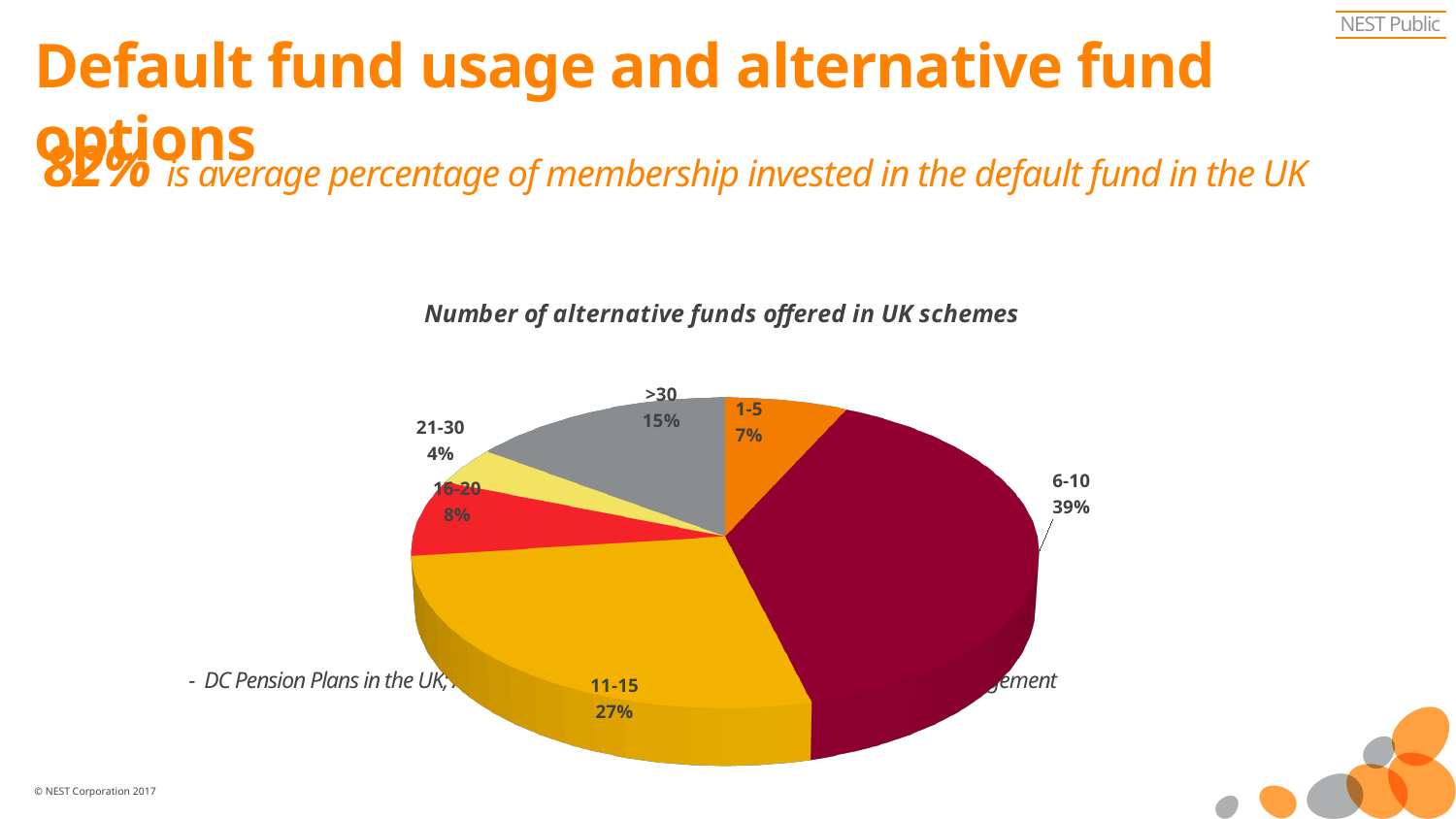
What is the difference in percentage points between the 6-10 and 11-15 categories? 12 Which category has the smallest share of the pie? 21-30 What is the title of the chart? Number of alternative funds offered in UK schemes What percentage of UK schemes offer 6-10 alternative funds? 39% What percentage of UK schemes offer more than 30 alternative funds? 15% Which is larger, the share for 16-20 or the share for >30? >30 How many categories are shown in the pie chart? 6 What kind of chart is shown on the slide? pie chart What percentage of UK schemes offer 11-15 alternative funds? 27% What percentage of UK schemes offer 1-5 alternative funds? 7% What is the combined share of the 1-5 and 21-30 categories? 11% Which category has the largest share of the pie? 6-10